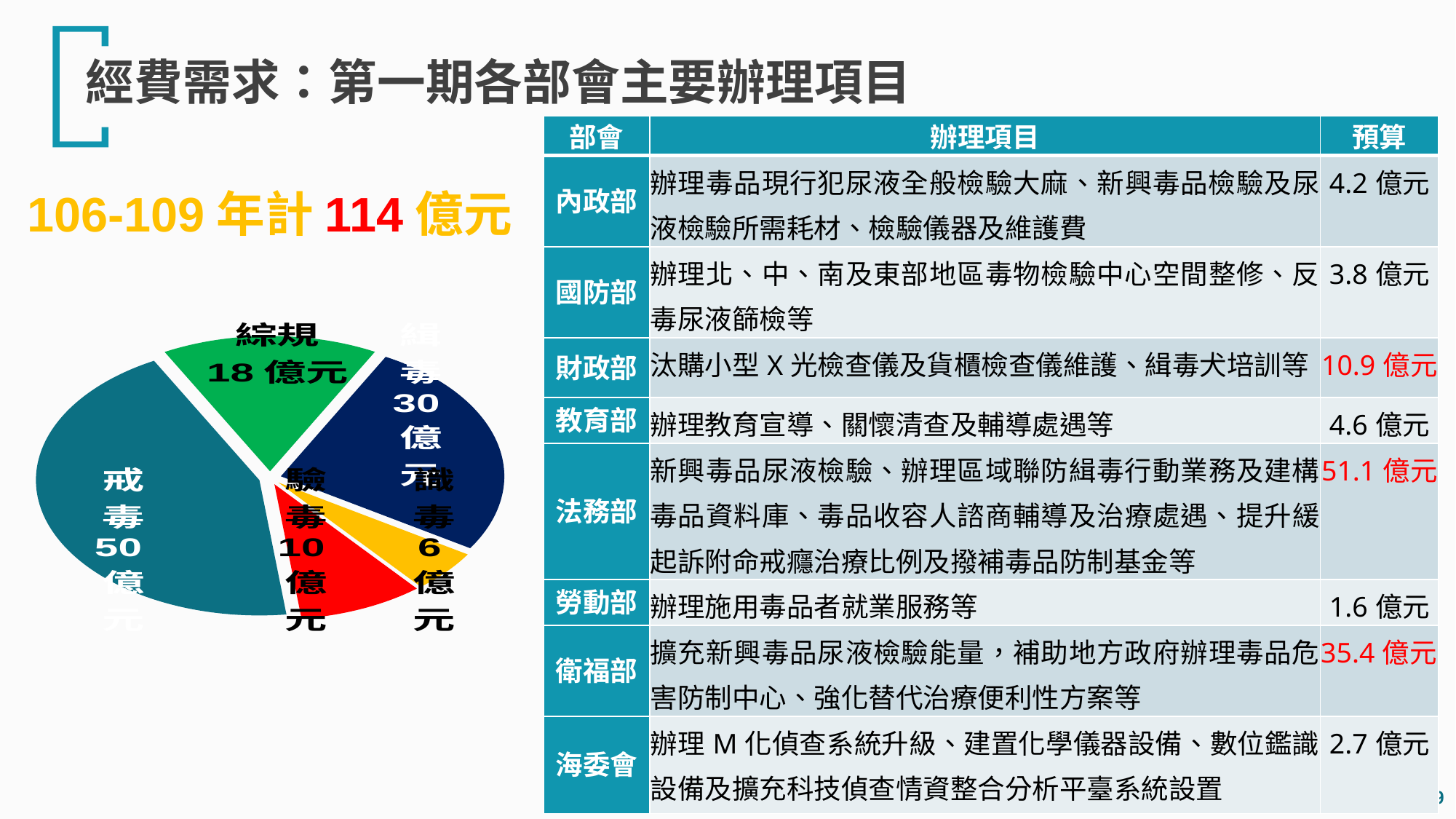
In the pie chart, what is the value for 緝毒? 30 億元 How many slices does the pie chart have? 5 What is the difference between the 戒毒 and 緝毒 values in the pie chart? 20 億元 What colour is the 綜規 slice in the pie chart? Green Which slice of the pie chart is the smallest? 識毒 In the pie chart, what is the value for 戒毒? 50 億元 In the pie chart, what is the value for 驗毒? 10 億元 What type of chart is shown on the left of the slide? Pie chart Which is larger in the pie chart, 綜規 or 驗毒? 綜規 In the pie chart, what is the value for 綜規? 18 億元 Which slice of the pie chart is the largest? 戒毒 In the pie chart, what is the value for 識毒? 6 億元